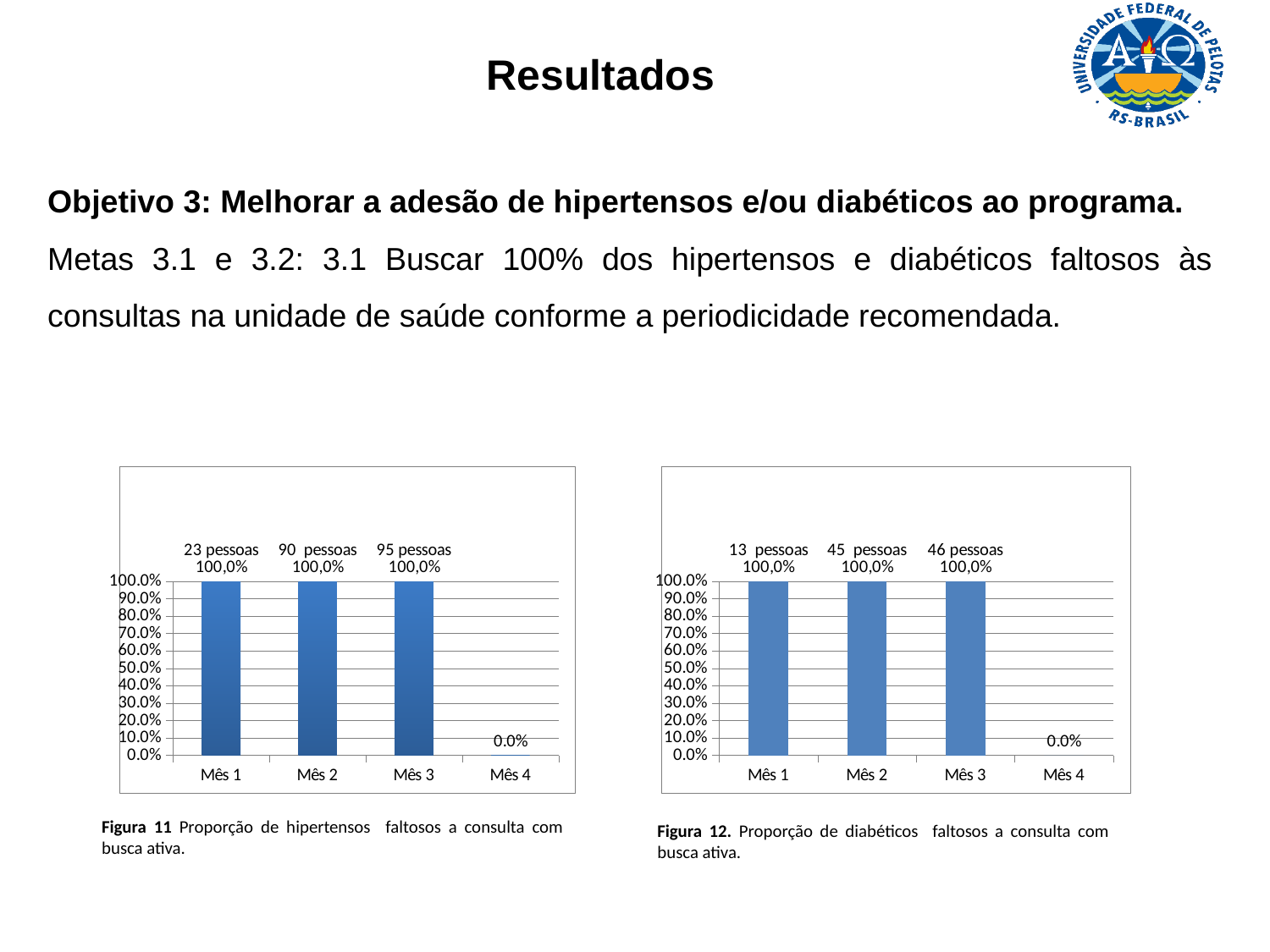
In the left chart (Figura 11, hipertensos), how many people does the label above the Mês 3 bar indicate? 95 pessoas In the right chart (Figura 12, diabéticos), how many month categories are shown on the x axis? 4 In the left chart (Figura 11, hipertensos), how many people does the label above the Mês 1 bar indicate? 23 pessoas In the left chart (Figura 11, hipertensos), is the value for Mês 1 larger or smaller than the value for Mês 4? Larger What is the caption of the right chart? Figura 12. Proporção de diabéticos faltosos a consulta com busca ativa. In the right chart (Figura 12, diabéticos), which month has the lowest value? Mês 4 In the right chart (Figura 12, diabéticos), what is the difference in number of people between Mês 3 and Mês 1? 33 pessoas In the left chart (Figura 11, hipertensos), what value is shown for Mês 2? 100,0% What kind of chart is the left chart (Figura 11)? Bar chart In the right chart (Figura 12, diabéticos), how many people does the label above the Mês 2 bar indicate? 45 pessoas In the right chart (Figura 12, diabéticos), what value is shown for Mês 3? 100,0% In the left chart (Figura 11, hipertensos), what value is shown for Mês 4? 0.0%